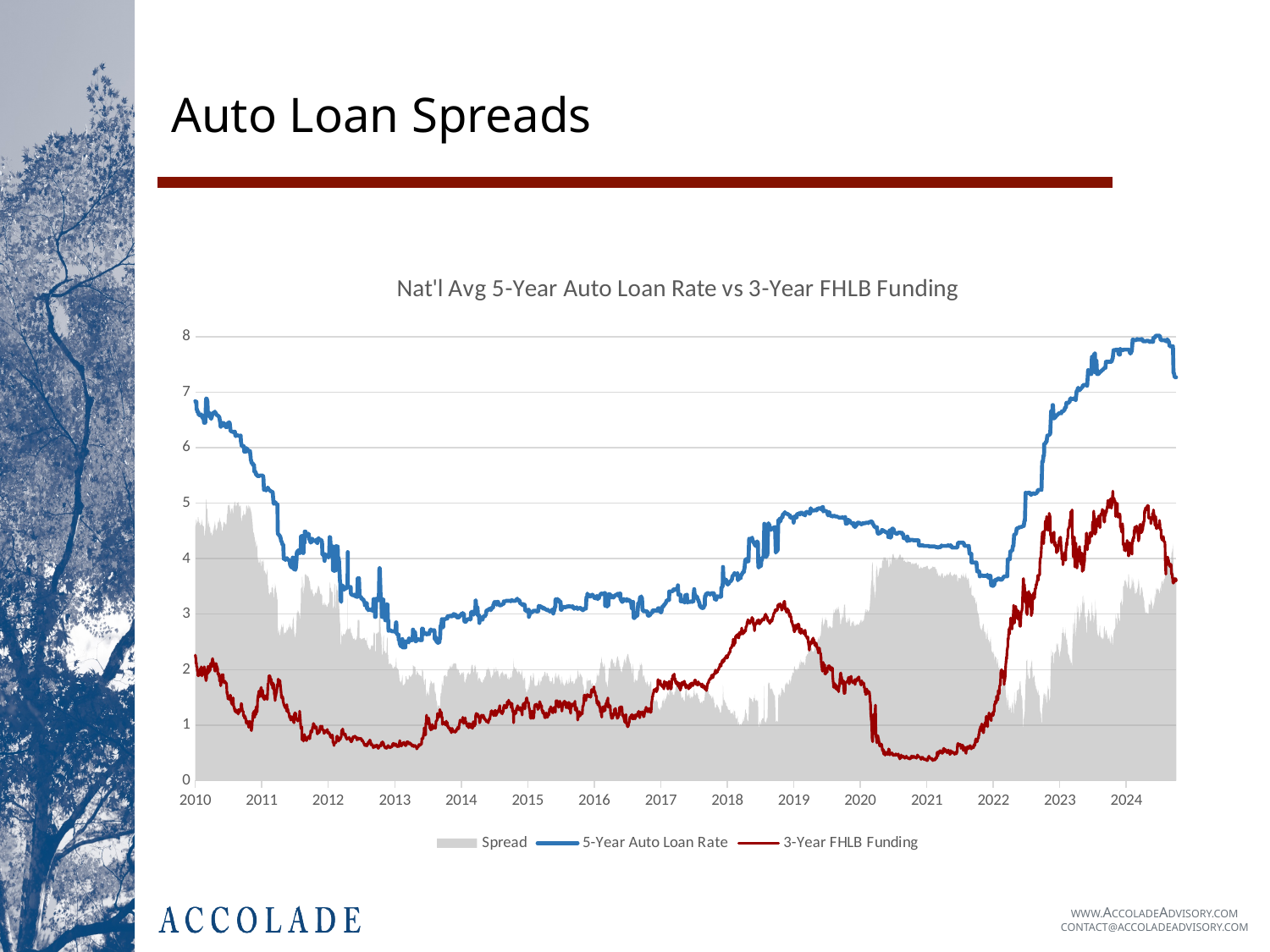
How many year labels are shown on the x axis? 15 What kind of chart is shown on the slide? Line chart What is the title of the chart? Nat'l Avg 5-Year Auto Loan Rate vs 3-Year FHLB Funding How many series does the legend list? 3 Is the 5-Year Auto Loan Rate in 2013 greater or less than 3? less Does the 5-Year Auto Loan Rate rise or fall from 2010 to 2013? Fall Which series is higher in 2024, the 5-Year Auto Loan Rate or the 3-Year FHLB Funding? 5-Year Auto Loan Rate Is the 5-Year Auto Loan Rate in 2019 greater or less than 4? greater Is the 3-Year FHLB Funding rate in 2021 greater or less than 1? less Does the 3-Year FHLB Funding rate rise or fall from 2021 to 2023? Rise Which series is shown as a grey shaded area? Spread